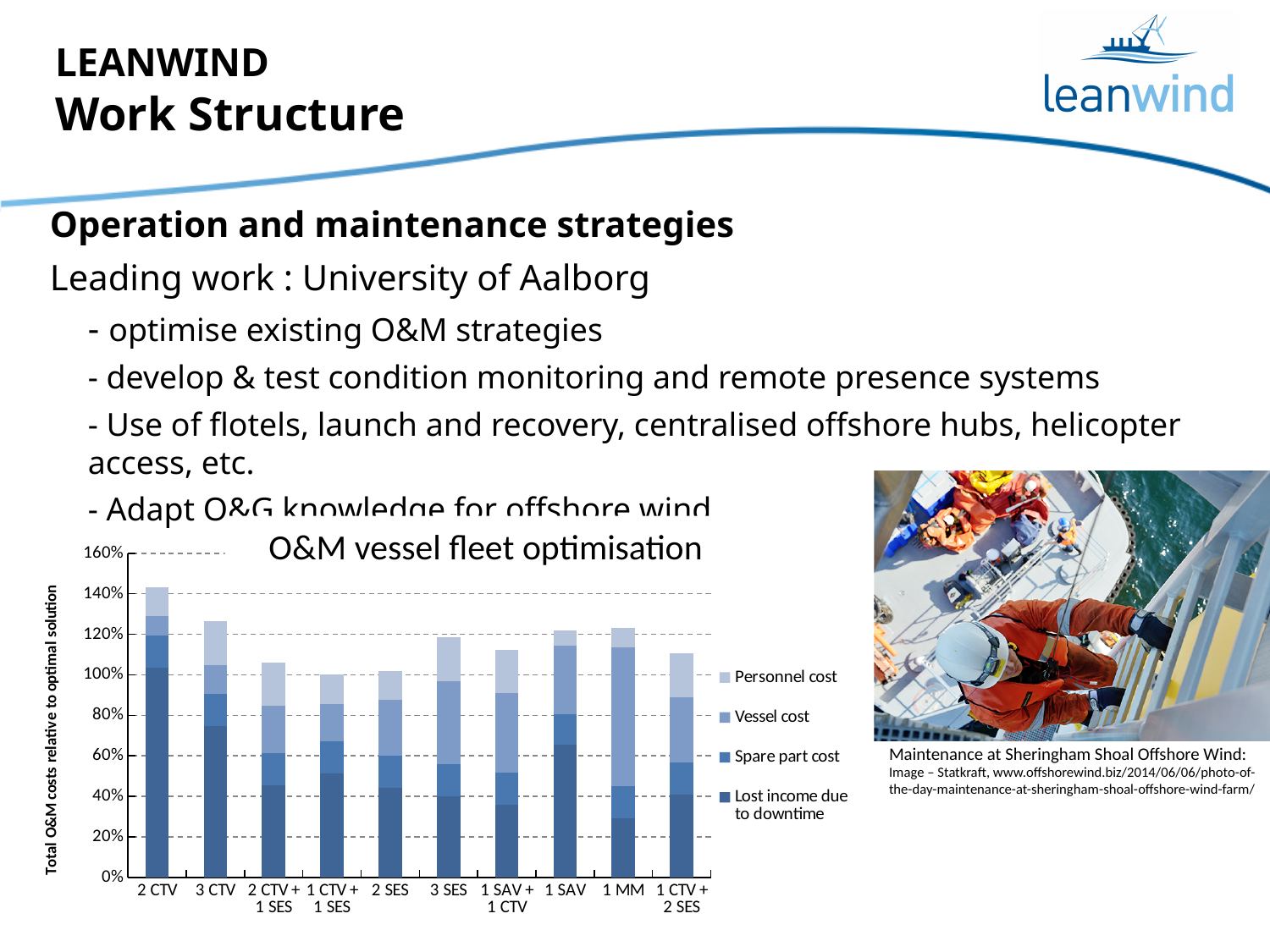
Is the total value for 1 SAV + 1 CTV greater or less than 120%? less Is the total value for 1 CTV + 2 SES greater or less than 100%? greater Is the total value for 2 CTV greater or less than 120%? greater Which has a higher total O&M cost, 2 CTV or 3 CTV? 2 CTV How many cost series does the chart legend list? 4 What is the total O&M cost relative to optimal solution for the 1 CTV + 1 SES configuration? 100% How many vessel fleet configurations are shown on the x axis of the chart? 10 What is the title of the chart? O&M vessel fleet optimisation What kind of chart is shown on the slide? Stacked bar chart Which has a higher total O&M cost, 1 MM or 2 SES? 1 MM What is the label on the vertical axis of the chart? Total O&M costs relative to optimal solution Which fleet configuration has the highest total O&M cost in the chart? 2 CTV